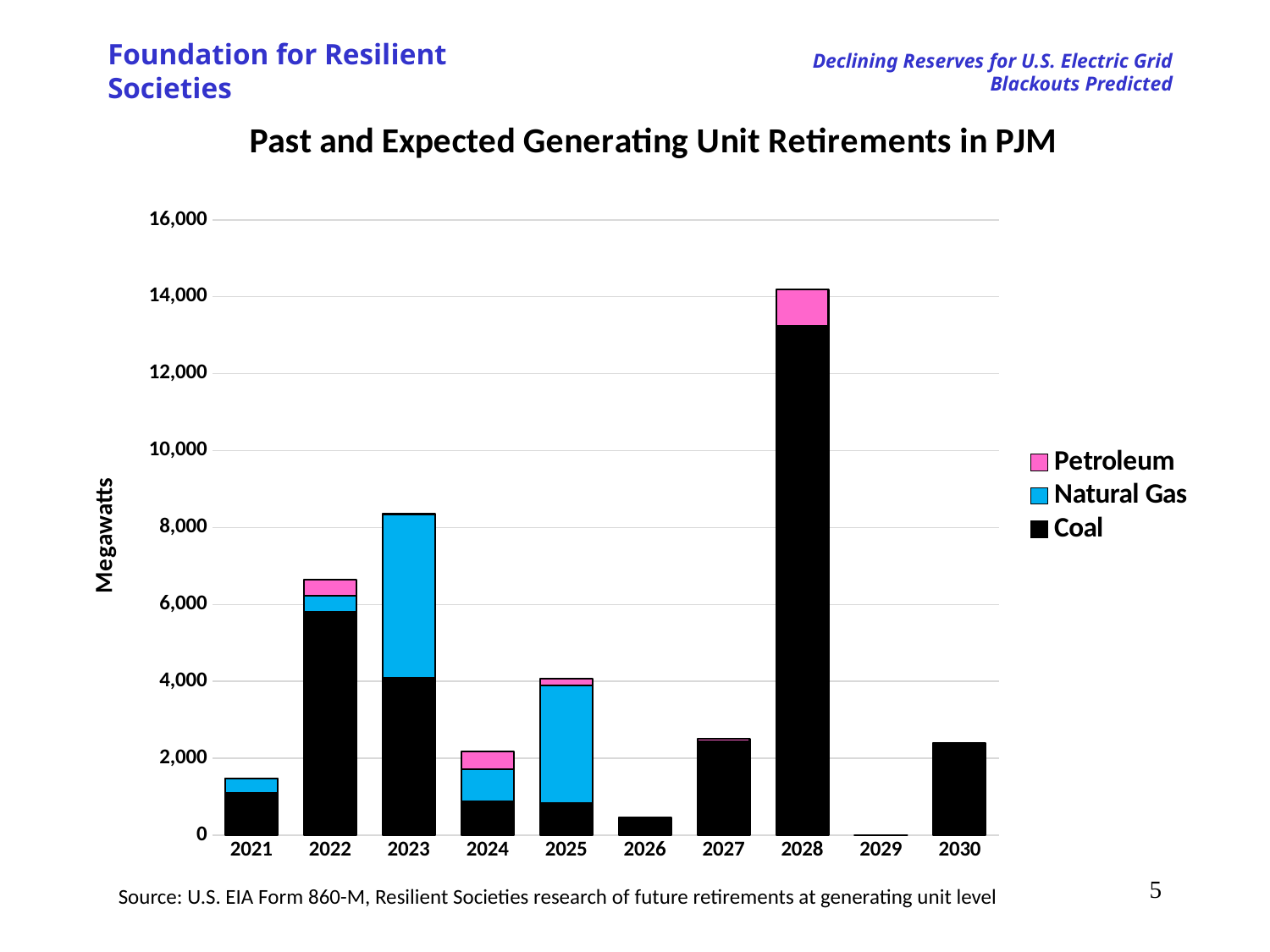
How many years are shown on the x axis? 10 Which year has the largest Natural Gas segment? 2023 Is the total value for 2023 greater or less than 8,000? greater Which year has the highest total generating unit retirements? 2028 Is the total value for 2030 greater or less than 2,000? greater What is the label on the y axis? Megawatts Which year has the lowest total generating unit retirements? 2029 Which year has the larger total retirements, 2022 or 2023? 2023 How many series does the legend list? 3 What kind of chart is shown on the slide? Stacked bar chart Is the total value for 2026 greater or less than 2,000? less